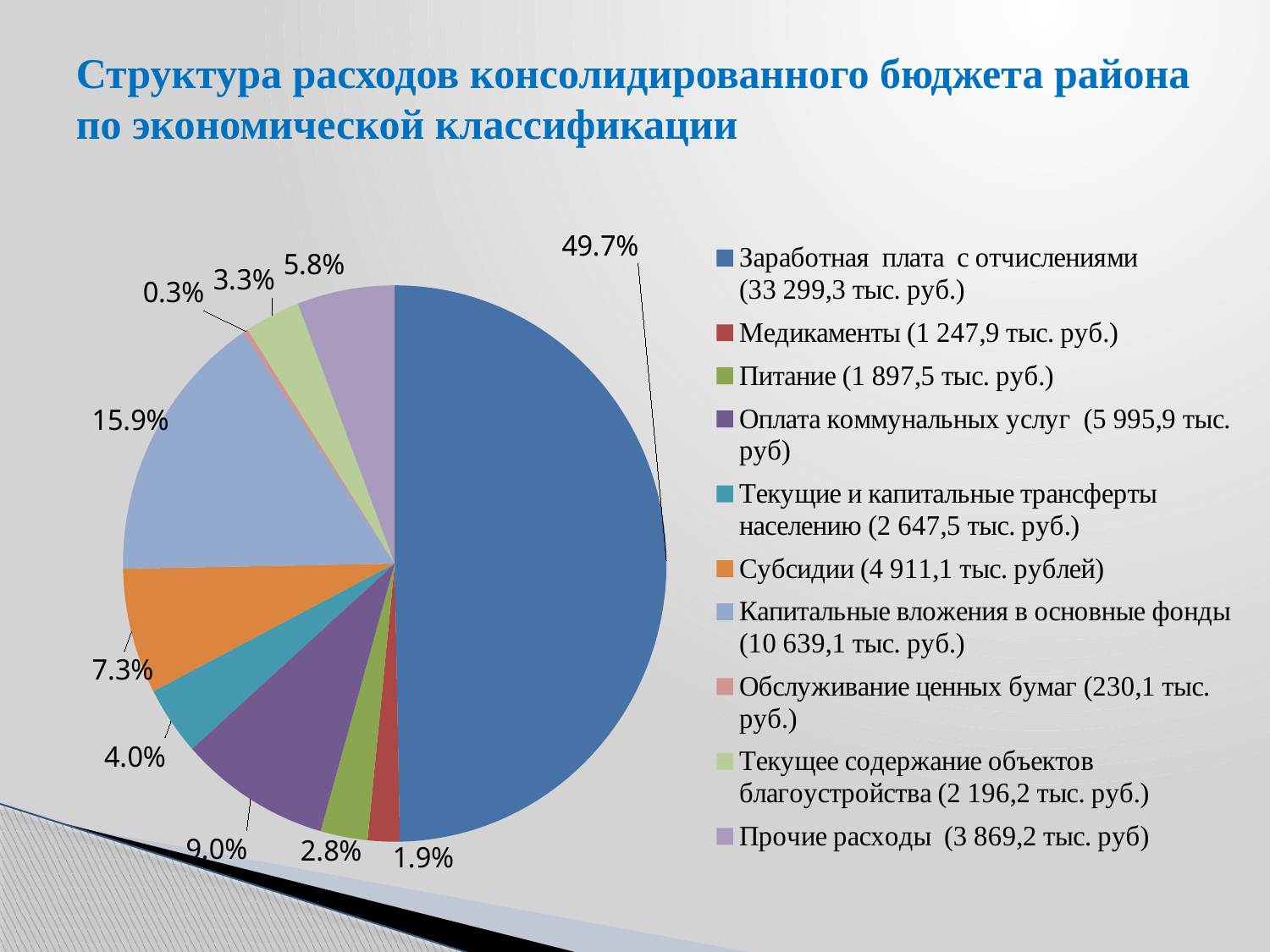
What share of the pie does "Оплата коммунальных услуг" take? 9.0% What amount in thousand rubles does the legend give for "Медикаменты"? 1 247,9 тыс. руб. What share of the pie does "Обслуживание ценных бумаг" take? 0.3% What share of the pie does "Заработная плата с отчислениями" take? 49.7% How many slices does the pie chart have? 10 Which is larger: the share for "Прочие расходы" or the share for "Текущие и капитальные трансферты населению"? Прочие расходы Which category has the largest share of the pie? Заработная плата с отчислениями What is the difference in percentage points between the share for "Капитальные вложения в основные фонды" and the share for "Оплата коммунальных услуг"? 6.9 Which category has the smallest share of the pie? Обслуживание ценных бумаг What kind of chart is shown on the slide? pie chart